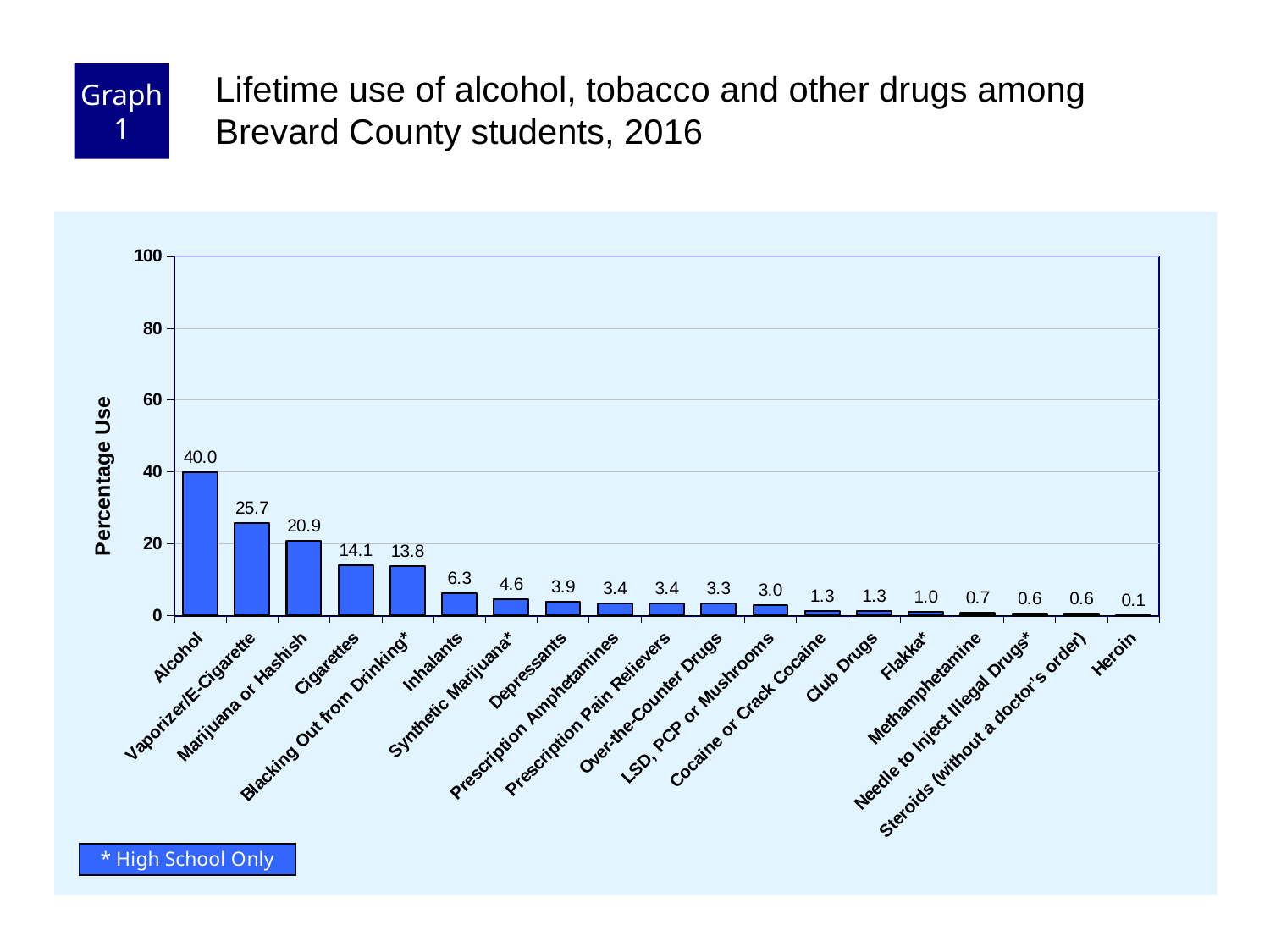
Which category has the lowest percentage use? Heroin What is the difference in percentage use between Alcohol and Cigarettes? 25.9 Which has a higher percentage use, Cigarettes or Inhalants? Cigarettes How many categories are shown on the x axis? 19 What is the percentage use for Vaporizer/E-Cigarette? 25.7 What kind of chart is shown on the slide? Bar chart What is the label of the y axis? Percentage Use Is the value for Vaporizer/E-Cigarette greater or less than 20? greater Which category has the highest percentage use? Alcohol What is the difference in percentage use between Marijuana or Hashish and Blacking Out from Drinking*? 7.1 What is the percentage use for Alcohol? 40.0 What is the percentage use for Inhalants? 6.3